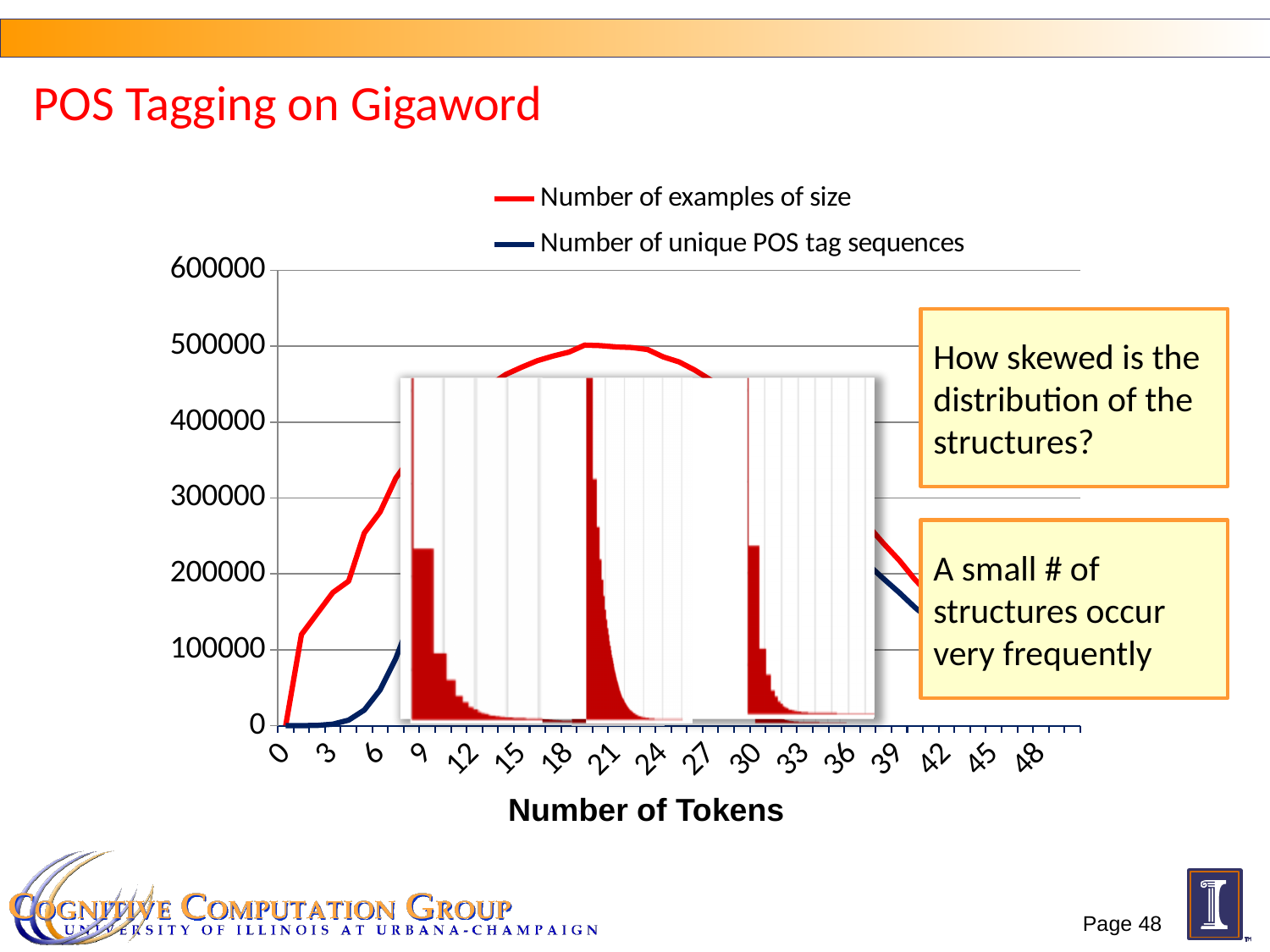
At 3 tokens, which series has the larger value, 'Number of examples of size' or 'Number of unique POS tag sequences'? Number of examples of size Is the value of 'Number of unique POS tag sequences' at 3 tokens greater or less than 100000? less Which series reaches the highest value anywhere on the chart? Number of examples of size What is the title of the x axis of the chart? Number of Tokens Does the 'Number of examples of size' series rise or fall between 39 and 48 tokens? fall Is the value of 'Number of examples of size' at 21 tokens greater or less than 400000? greater Is the value of 'Number of examples of size' at 6 tokens greater or less than 200000? greater Which series is drawn in red in the chart? Number of examples of size What kind of chart is shown on the slide? line chart How many series does the chart's legend list? 2 Does the 'Number of examples of size' series rise or fall between 0 and 18 tokens? rise